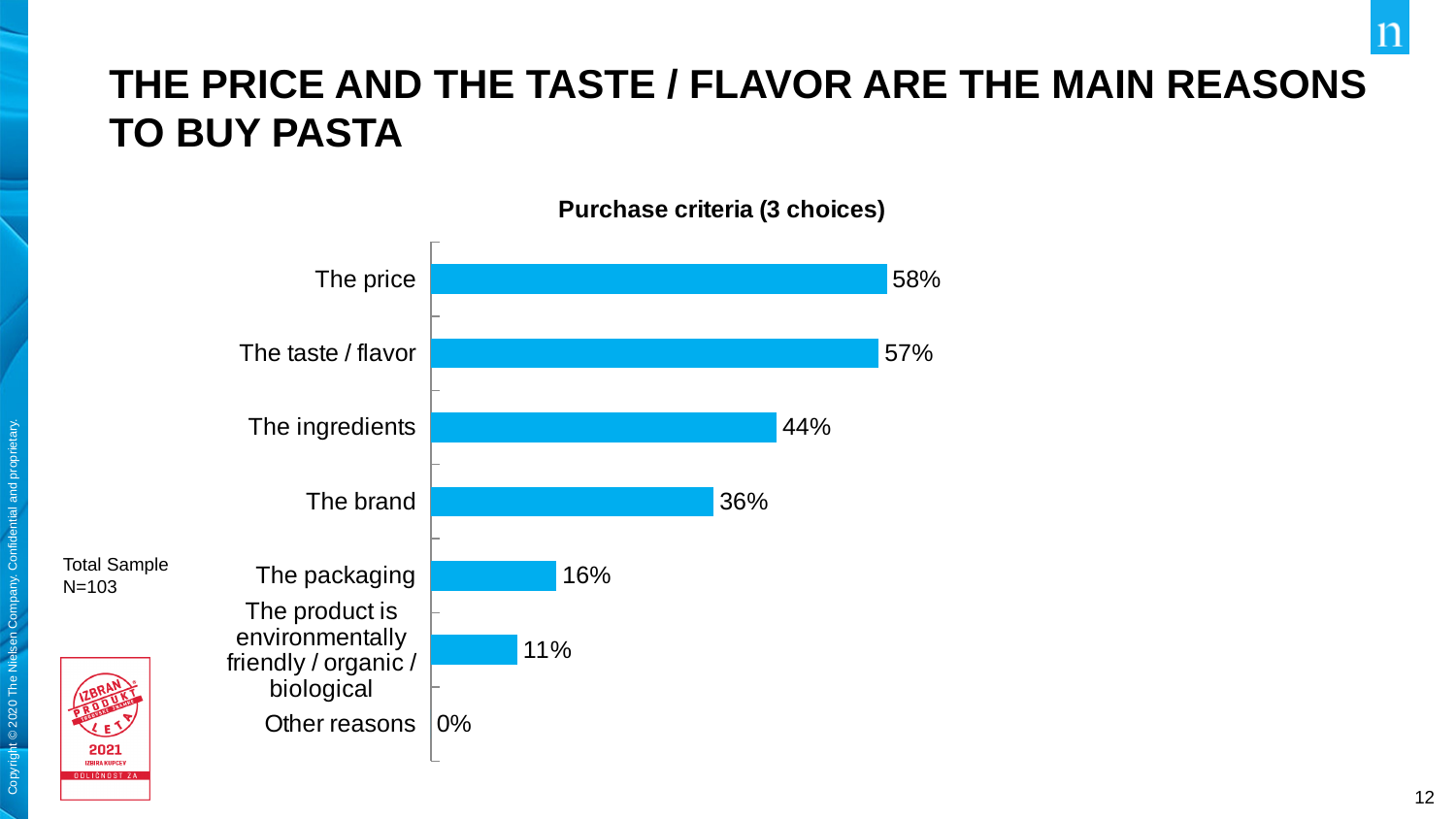
What is the value shown for 'The product is environmentally friendly / organic / biological'? 11% What type of chart is shown on the slide? Bar chart Which purchase criterion has the highest value? The price How many purchase criteria categories are shown in the chart? 7 What is the value shown for 'The packaging'? 16% What is the difference between the values for 'The ingredients' and 'The packaging'? 28% What is the value shown for 'The ingredients'? 44% What is the title of the chart? Purchase criteria (3 choices) What percentage of respondents chose 'The price' as a purchase criterion? 58% What is the difference between the values for 'The price' and 'The brand'? 22% Which purchase criterion has the lowest value? Other reasons Which has a larger value, 'The brand' or 'The packaging'? The brand